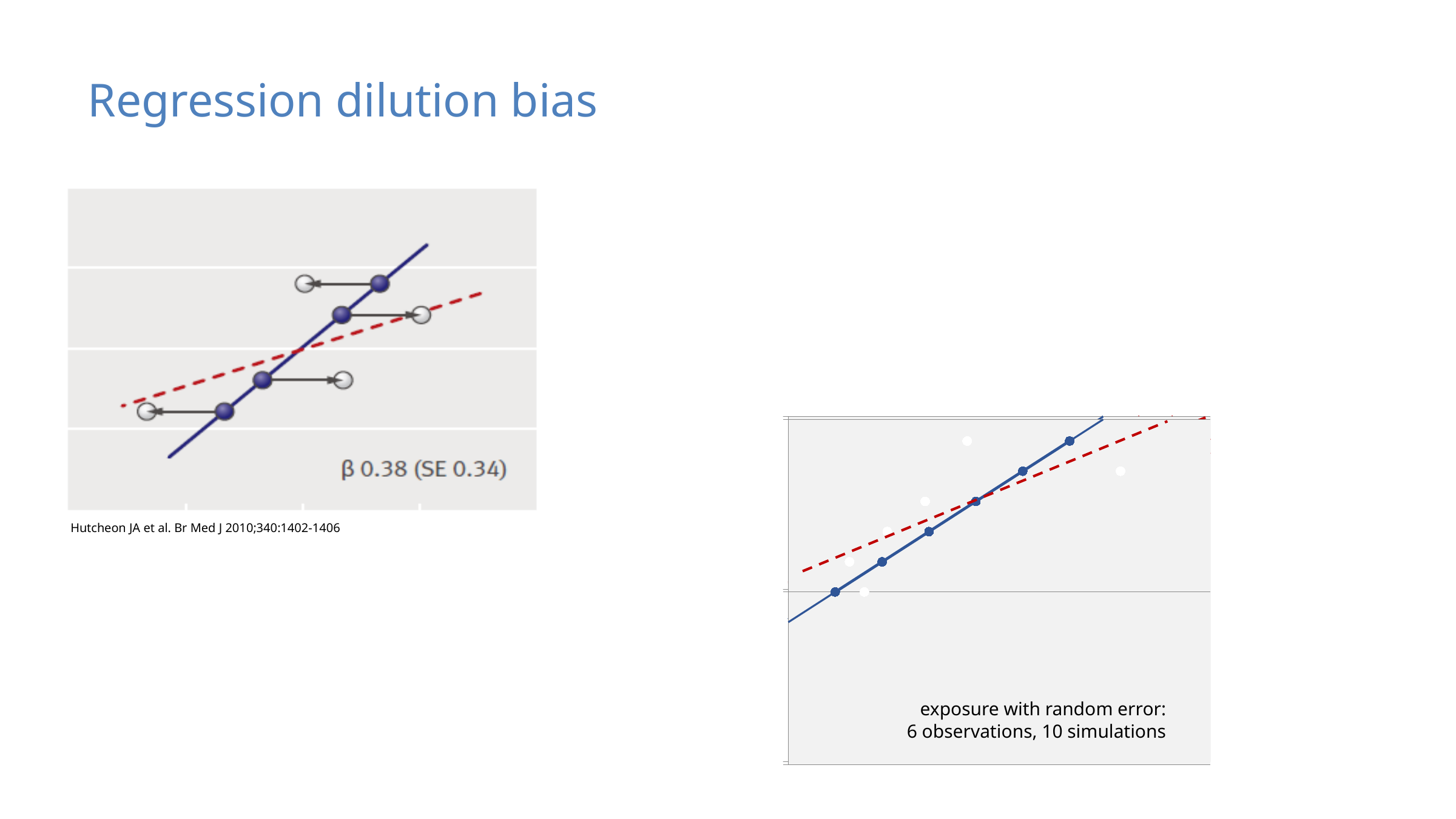
In the right chart, how many blue points lie on the solid line? 6 In the right chart, what colour and style is the line with the shallower slope? red dashed In the left chart, do the blue points rise or fall from left to right along the x axis? rise In the right chart, do the blue points rise or fall from left to right along the x axis? rise In the right chart, how many simulations does the caption mention? 10 simulations In the left chart, what standard error (SE) is printed next to the β value? 0.34 What kind of chart is shown on the right of the slide? scatter chart In the left chart, how many blue (filled) points are plotted? 4 What kind of chart is shown on the left of the slide? scatter chart In the left chart, what regression coefficient β is printed? β 0.38 (SE 0.34)